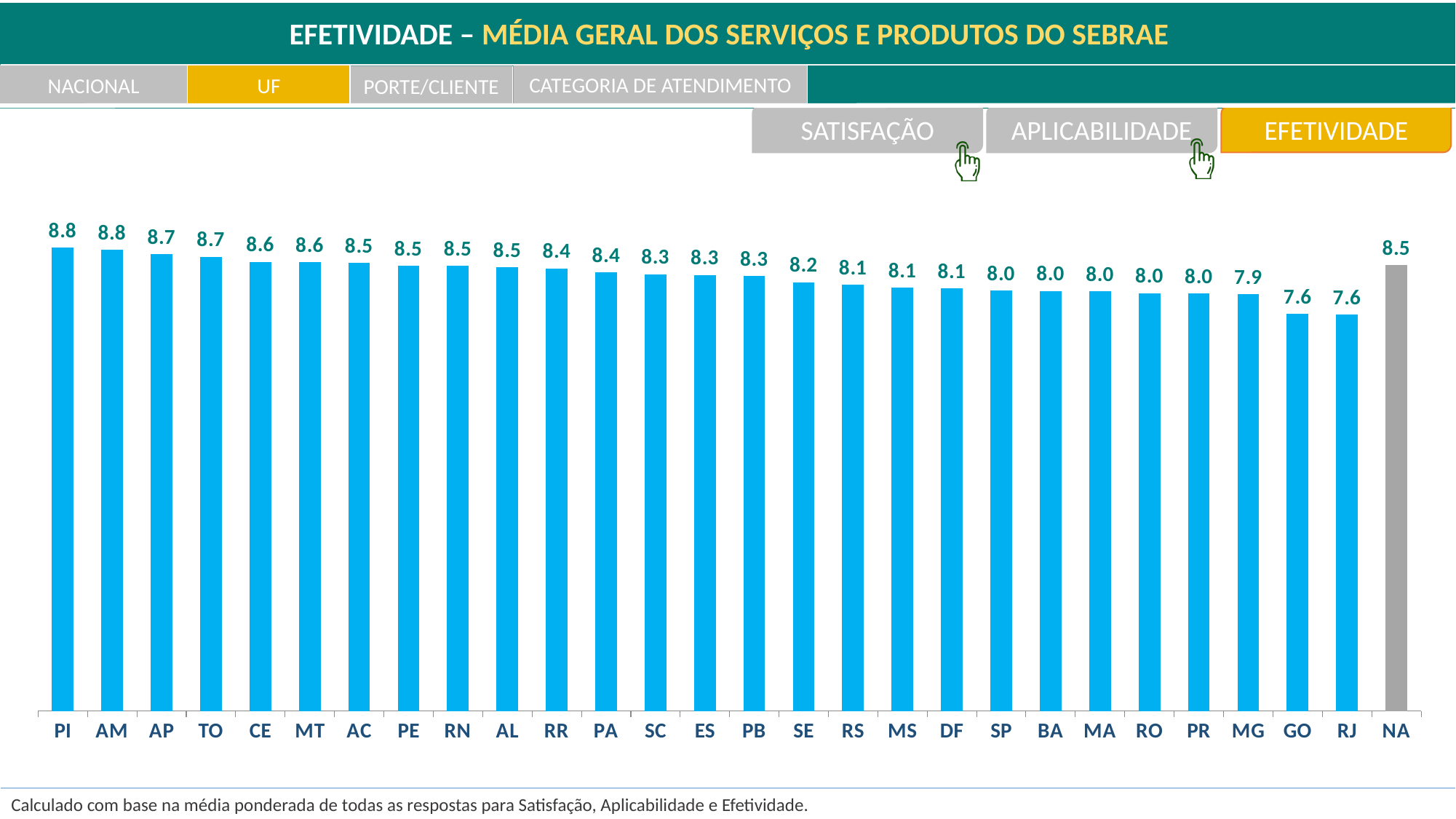
What is the difference between the values for PI and RJ? 1.2 Do the values for the UF bars generally rise or fall from left to right? Fall What is the value for SE? 8.2 What is the value for PI? 8.8 How many bars are plotted on the chart? 28 What kind of chart is shown on the slide? Bar chart What is the value for MG? 7.9 Which two categories share the lowest value on the chart? GO and RJ Which is larger, the value for CE or the value for DF? CE What is the lowest value shown on the chart? 7.6 What is the value for NA? 8.5 What is the difference between the values for NA and SP? 0.5